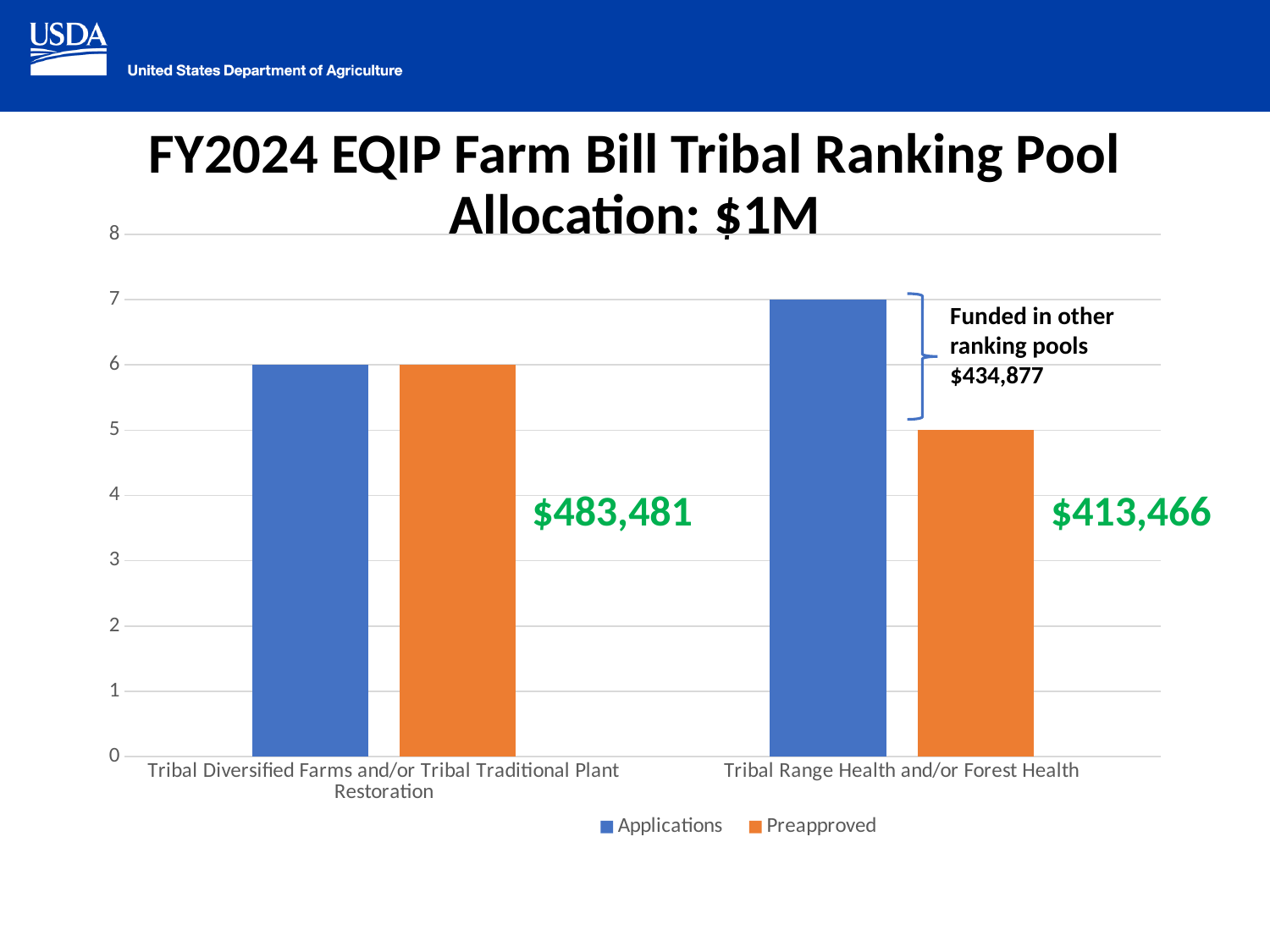
What is the number of Applications for Tribal Diversified Farms and/or Tribal Traditional Plant Restoration? 6 What dollar amount is annotated next to the Tribal Diversified Farms and/or Tribal Traditional Plant Restoration bars? $483,481 What kind of chart is shown on the slide? bar chart What is the title of the chart? FY2024 EQIP Farm Bill Tribal Ranking Pool Allocation: $1M For Tribal Range Health and/or Forest Health, which is larger: Applications or Preapproved? Applications How many series does the legend list? 2 What is the number of Preapproved for Tribal Range Health and/or Forest Health? 5 How many categories are shown on the x axis? 2 What is the difference between Applications and Preapproved for Tribal Range Health and/or Forest Health? 2 Which category has the highest number of Applications? Tribal Range Health and/or Forest Health What is the number of Applications for Tribal Range Health and/or Forest Health? 7 Which category has the lowest Preapproved value? Tribal Range Health and/or Forest Health